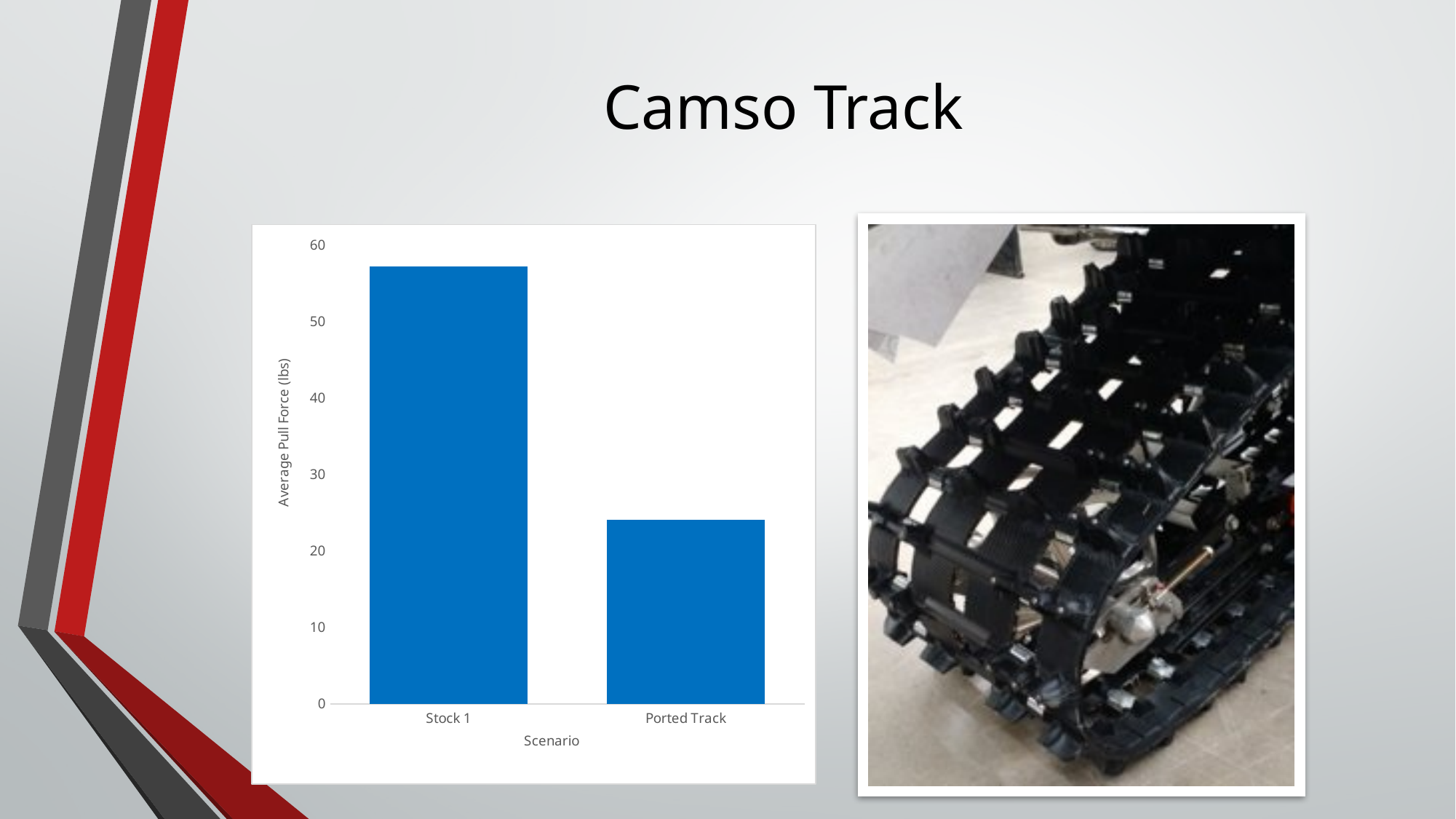
Is the average pull force for Ported Track greater or less than 20? greater Is the average pull force for Ported Track greater or less than 30? less What is the label of the y axis of the chart? Average Pull Force (lbs) What is the label of the x axis of the chart? Scenario Which scenario has the highest average pull force? Stock 1 Which has a larger average pull force, Stock 1 or Ported Track? Stock 1 Which scenario has the lowest average pull force? Ported Track What kind of chart is shown on the slide? bar chart Do the values fall or rise from Stock 1 to Ported Track? fall How many categories are shown on the x axis of the chart? 2 Is the average pull force for Stock 1 greater or less than 60? less